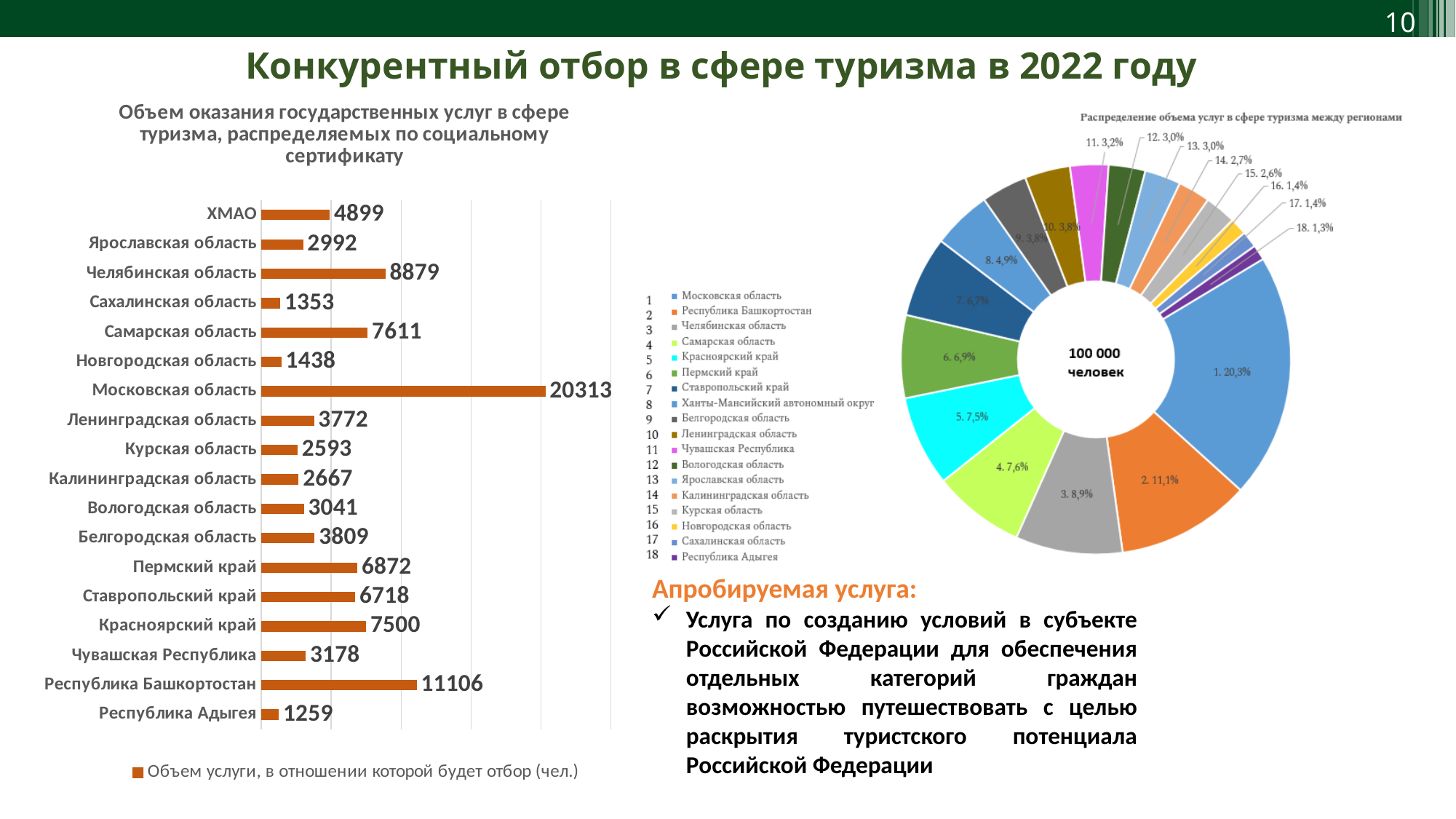
How many regions are shown in the bar chart on the left? 18 In the bar chart on the left, what is the legend entry for the series? Объем услуги, в отношении которой будет отбор (чел.) In the bar chart on the left, what is the difference between the values for Челябинская область and Самарская область? 1268 In the pie chart on the right, what share does Республика Адыгея (slice 18) have? 1,3% In the pie chart on the right, what share does Московская область (slice 1) have? 20,3% In the bar chart on the left, what is the value for Республика Башкортостан? 11106 In the bar chart on the left, which region has the highest value? Московская область What type of chart is the chart on the left of the slide? Bar chart What total number of people is shown in the centre of the pie chart on the right? 100 000 человек In the bar chart on the left, what is the value for Московская область? 20313 In the bar chart on the left, which is larger: the value for Пермский край or Ставропольский край? Пермский край In the bar chart on the left, which region has the lowest value? Республика Адыгея